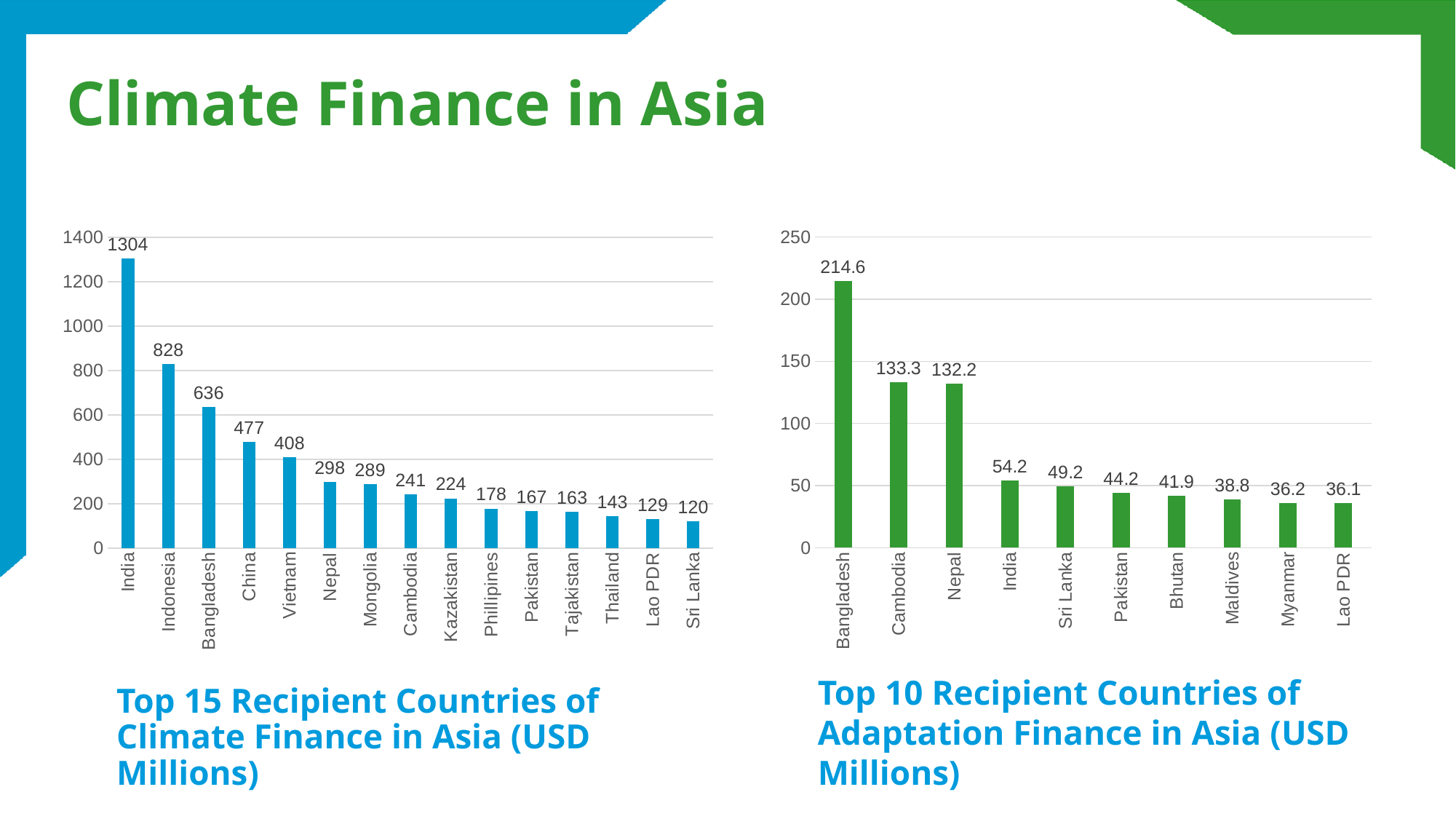
In the Top 15 Recipient Countries of Climate Finance chart, do the values rise or fall from left to right? fall In the Top 10 Recipient Countries of Adaptation Finance chart, what is the value for Bangladesh? 214.6 In the Top 15 Recipient Countries of Climate Finance chart, what is the difference between India and Bangladesh? 668 In the Top 10 Recipient Countries of Adaptation Finance chart, what is the value for Maldives? 38.8 In the Top 15 Recipient Countries of Climate Finance chart, what is the value for Indonesia? 828 What colour are the bars in the Top 15 Recipient Countries of Climate Finance chart? blue In the Top 15 Recipient Countries of Climate Finance chart, how many countries are shown? 15 In the Top 10 Recipient Countries of Adaptation Finance chart, which is larger, Cambodia or India? Cambodia In the Top 10 Recipient Countries of Adaptation Finance chart, what is the difference between Cambodia and Nepal? 1.1 What kind of chart is the Top 10 Recipient Countries of Adaptation Finance chart? bar chart In the Top 15 Recipient Countries of Climate Finance chart, which country has the lowest value? Sri Lanka In the Top 15 Recipient Countries of Climate Finance chart, which country has the highest value? India